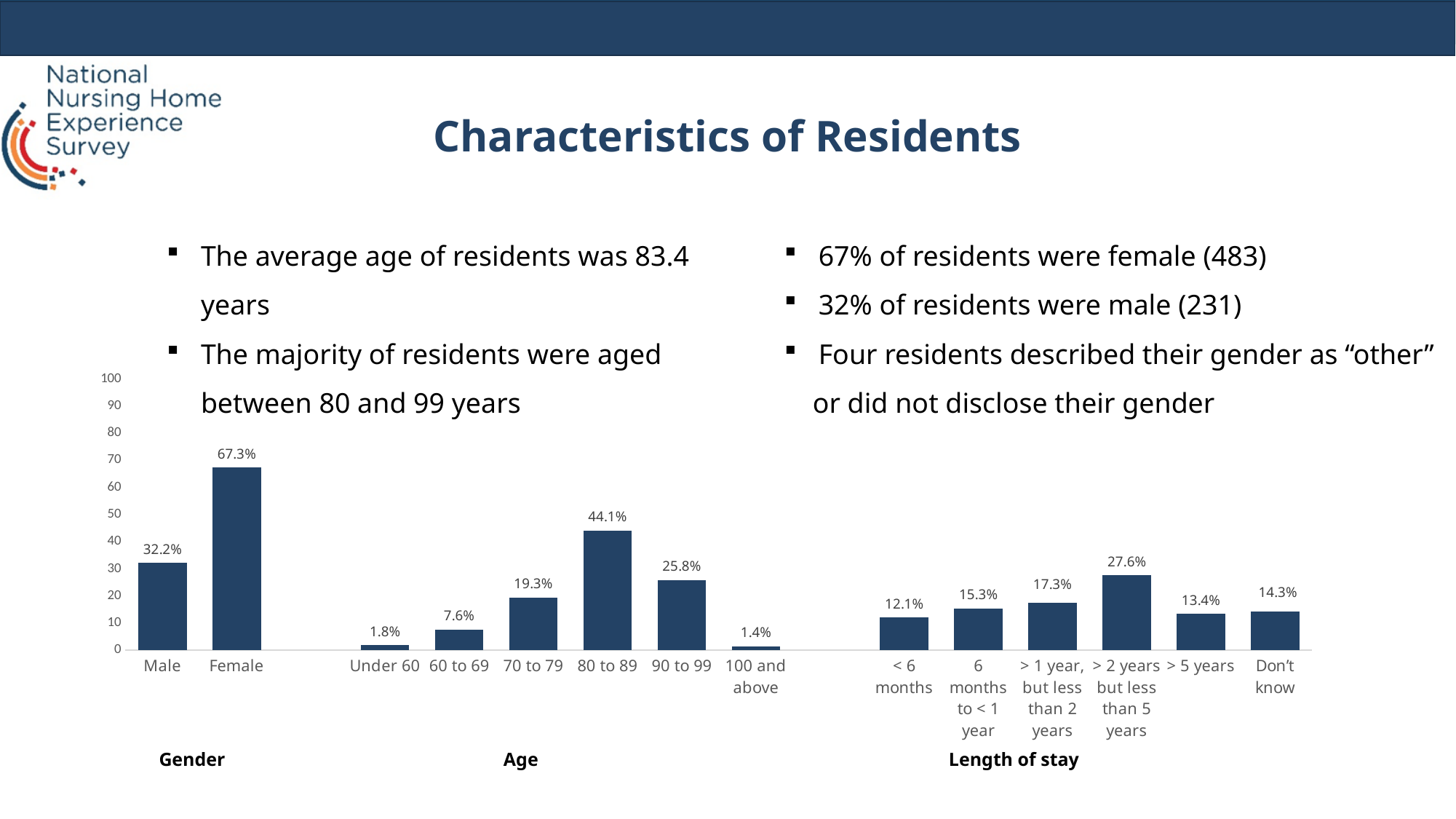
Which length-of-stay category has the highest value in the Length of stay group of the chart? > 2 years but less than 5 years How many categories are shown in the Length of stay group of the chart? 6 What are the three group labels shown beneath the chart? Gender, Age, Length of stay What percentage of residents were female according to the Gender group of the chart? 67.3% Which age category has the lowest value in the Age group of the chart? 100 and above In the Age group of the chart, which is larger: the value for 70 to 79 or the value for 90 to 99? 90 to 99 In the Length of stay group of the chart, what is the difference between the '< 6 months' value and the '6 months to < 1 year' value? 3.2% In the Length of stay group of the chart, what is the value for '> 2 years but less than 5 years'? 27.6% In the Age group of the chart, what is the value for residents aged 80 to 89? 44.1% What is the difference between the Female and Male values in the Gender group of the chart? 35.1% What kind of chart is shown on the slide? Bar chart How many age categories are shown in the Age group of the chart? 6